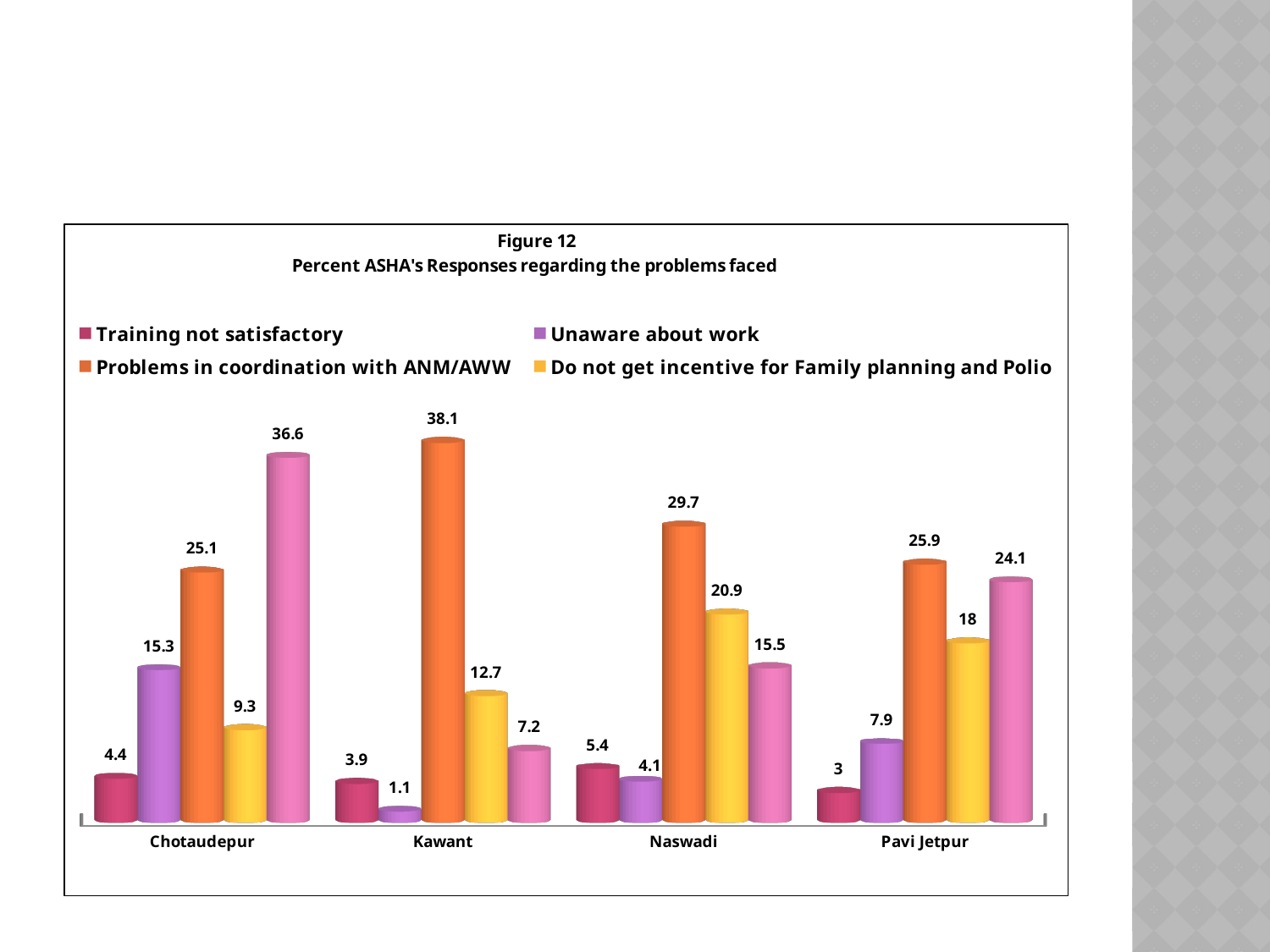
How many series does the legend list? 4 Which category has the lowest value for "Unaware about work"? Kawant How many categories are shown on the x axis? 4 Which is larger: "Do not get incentive for Family planning and Polio" in Pavi Jetpur or in Kawant? Pavi Jetpur What is the value for "Training not satisfactory" in Pavi Jetpur? 3 What is the figure number given in the chart title? Figure 12 What is the value for "Problems in coordination with ANM/AWW" in Kawant? 38.1 Which category has the highest value for "Problems in coordination with ANM/AWW"? Kawant What kind of chart is shown? Bar chart What is the value for "Do not get incentive for Family planning and Polio" in Naswadi? 20.9 What is the difference between the "Problems in coordination with ANM/AWW" values for Naswadi and Pavi Jetpur? 3.8 What is the value for "Unaware about work" in Chotaudepur? 15.3